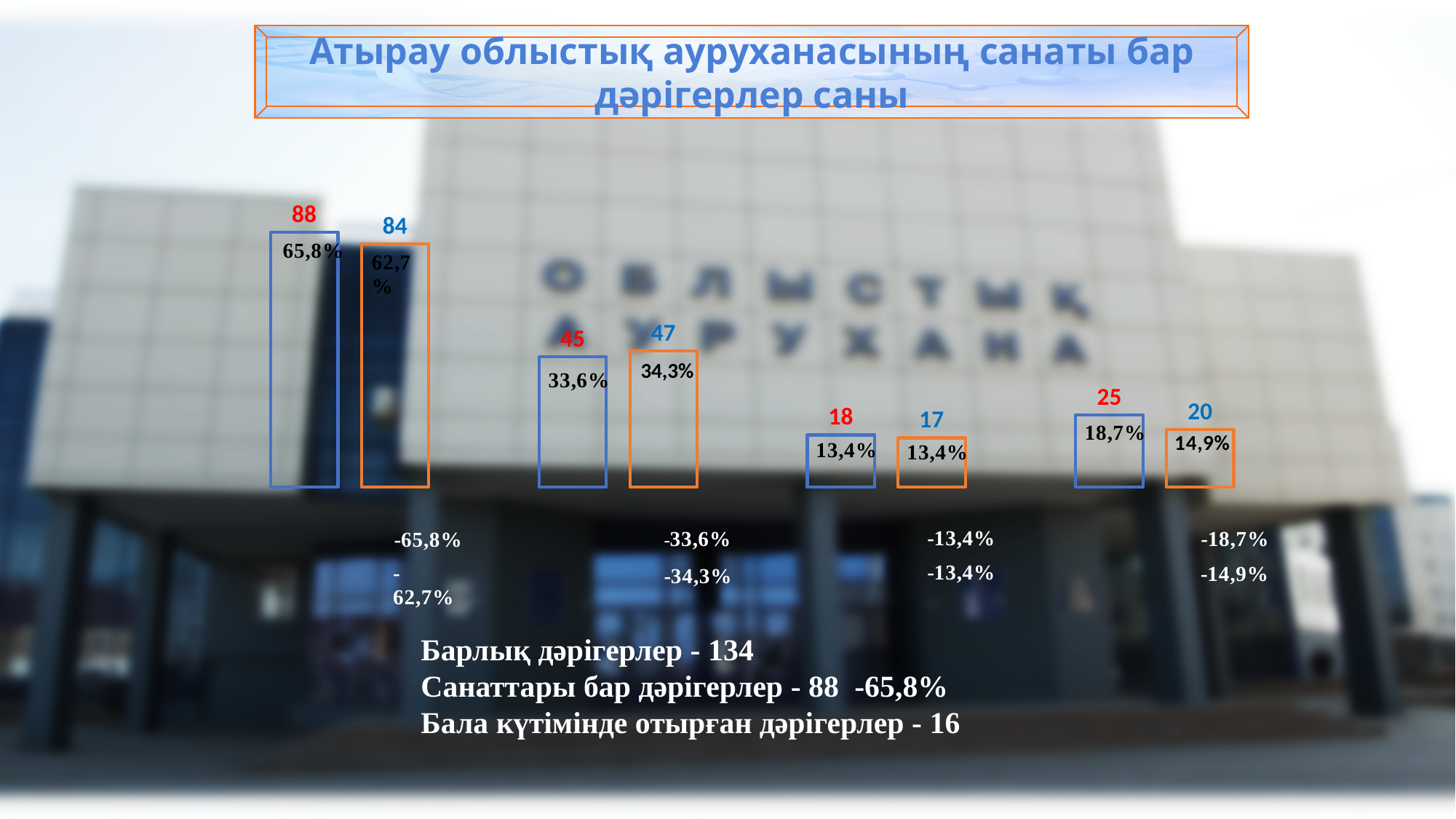
What value is labelled on the shortest bar in the chart? 17 How many bars are plotted in the chart? 8 What percentage is printed inside the first (leftmost) blue bar? 65,8% What percentage is printed inside the orange bar in the second pair of bars? 34,3% What is the difference between the blue bar (25) and the orange bar (20) in the rightmost pair? 5 What is the title of the chart on the slide? Атырау облыстық ауруханасының санаты бар дәрігерлер саны In the second pair of bars, which is larger: the blue bar (45) or the orange bar (47)? the orange bar (47) What kind of chart is shown on the slide? bar chart What is the difference between the two bars in the first (leftmost) pair, 88 and 84? 4 What value is labelled above the orange bar in the first (leftmost) pair of bars? 84 What value is labelled on the tallest bar in the chart? 88 Do the bar values generally rise or fall from left to right across the chart? fall